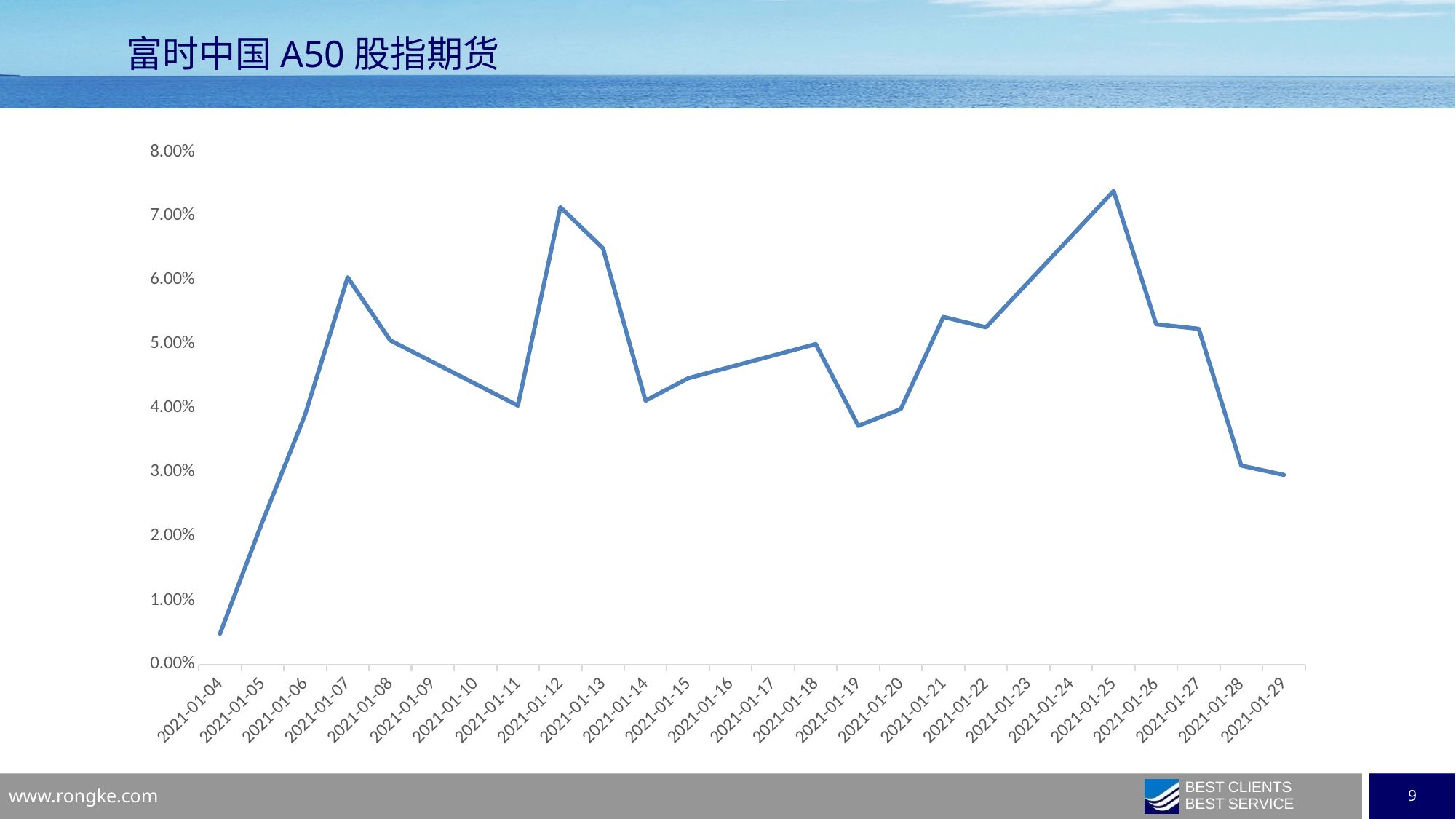
Do the values rise or fall from 2021-01-25 to 2021-01-29? fall Which is larger, the value for 2021-01-12 or the value for 2021-01-25? 2021-01-25 Is the value for 2021-01-25 greater or less than 7.00%? greater How many dates are plotted along the x axis? 26 What is the title of the chart? 富时中国 A50 股指期货 What kind of chart is shown on the slide? line chart Which is larger, the value for 2021-01-13 or the value for 2021-01-14? 2021-01-13 On which date does the line reach its highest value? 2021-01-25 Is the value for 2021-01-19 greater or less than 4.00%? less Is the value for 2021-01-04 greater or less than 1.00%? less On which date does the line reach its lowest value? 2021-01-04